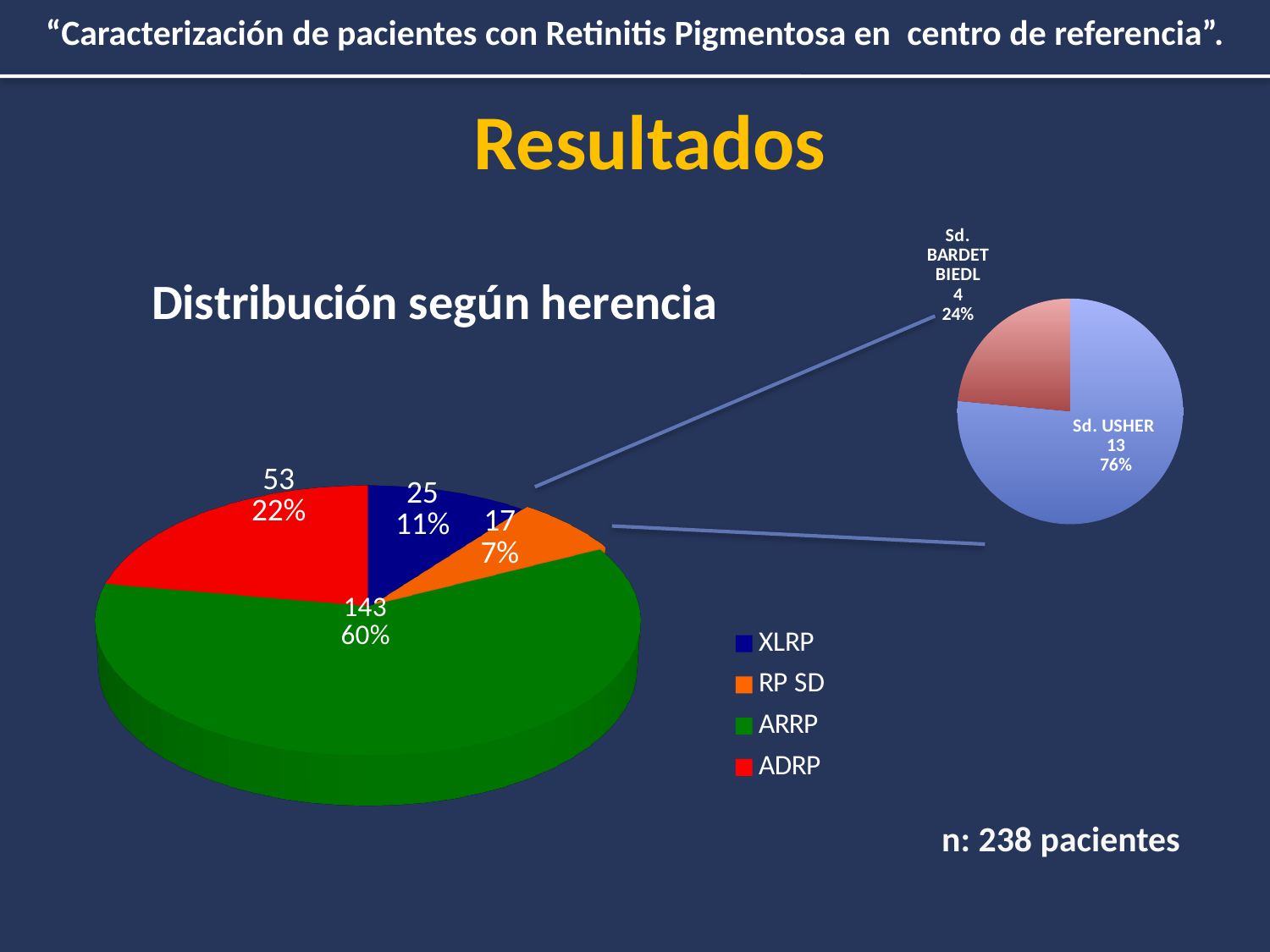
What type of chart is 'Distribución según herencia'? Pie chart In the smaller pie chart on the right, what is the difference in patient count between Sd. USHER and Sd. BARDET BIEDL? 9 In the smaller pie chart on the right, how many patients have Sd. USHER? 13 In the 'Distribución según herencia' pie chart, how many patients are in the ARRP category? 143 In the 'Distribución según herencia' pie chart, what percentage does XLRP represent? 11% How many categories does the legend of the 'Distribución según herencia' pie chart list? 4 In the 'Distribución según herencia' pie chart, what is the difference in patient count between ADRP and XLRP? 28 In the 'Distribución según herencia' pie chart, which category has the smallest slice? RP SD In the 'Distribución según herencia' pie chart, which has more patients, ADRP or RP SD? ADRP In the smaller pie chart on the right, what percentage does Sd. BARDET BIEDL represent? 24% In the 'Distribución según herencia' pie chart, which category has the largest slice? ARRP In the 'Distribución según herencia' pie chart, what colour is the ARRP slice? Green